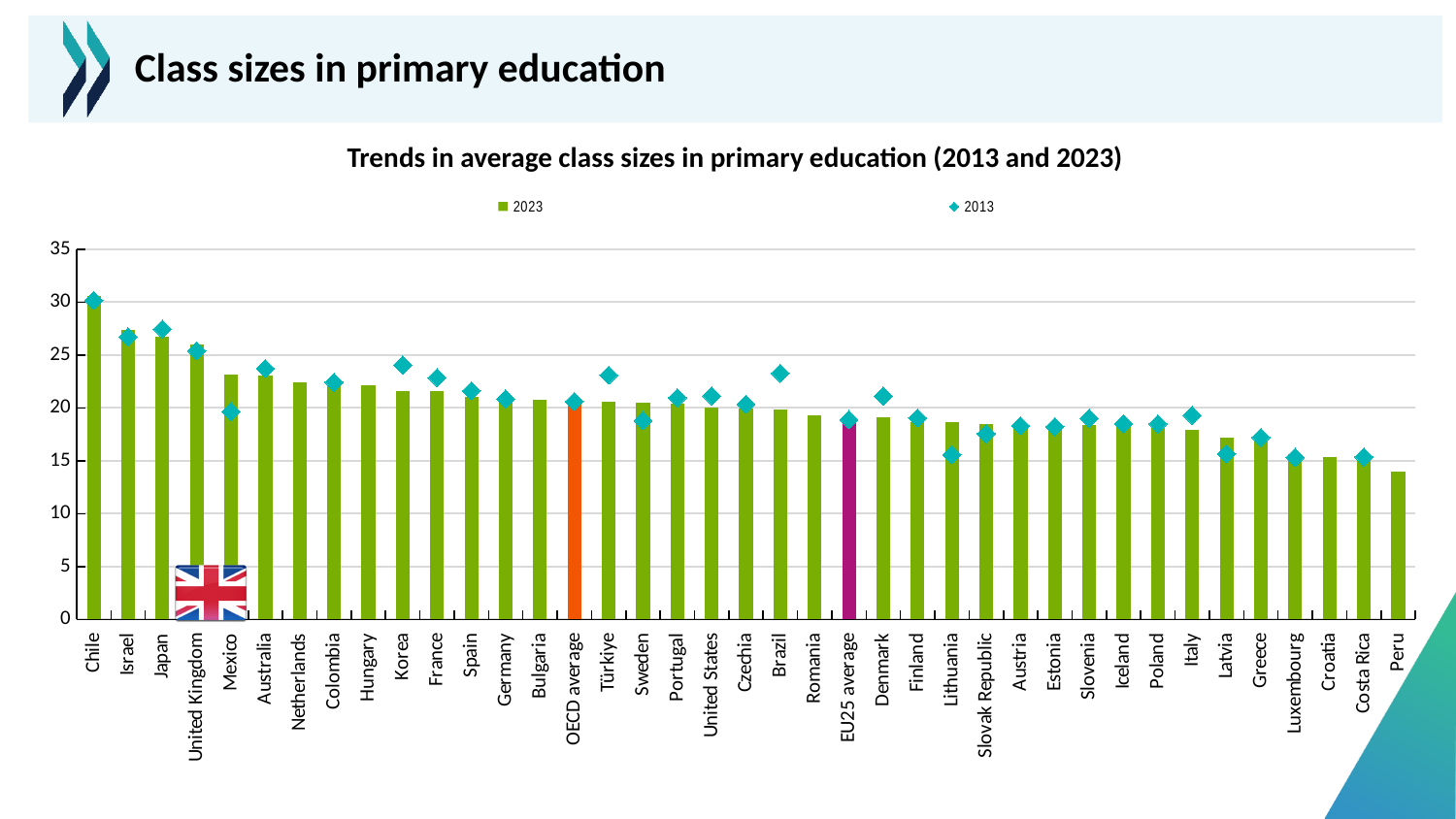
Which series is shown as green bars? 2023 Is the 2013 value for Lithuania greater or less than 20? less Which country has the lowest 2023 average class size? Peru Is the 2023 value for Peru greater or less than 15? less Is the 2023 value for Chile greater or less than 25? greater Do the 2023 bars rise or fall from left to right along the x axis? Fall For Mexico, which is larger: the 2023 value or the 2013 value? 2023 For Korea, which is larger: the 2023 value or the 2013 value? 2013 Which country has the highest 2023 average class size? Chile How many series does the legend list? 2 What type of chart is shown on the slide? Bar chart